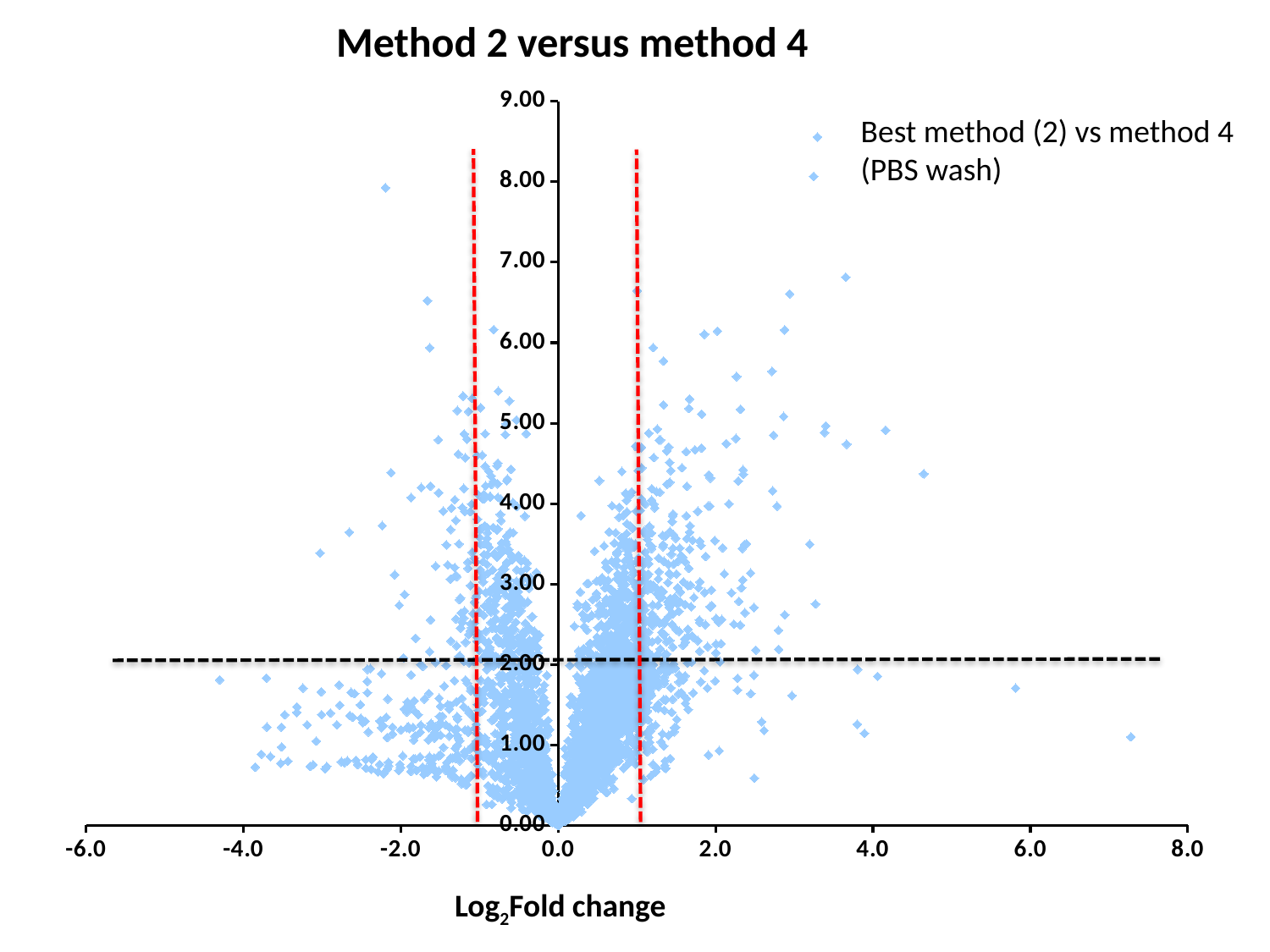
What is the maximum value shown on the y axis? 9.00 Is the y value of the highest plotted point greater or less than 7.00? greater What is the title of the chart? Method 2 versus method 4 What is the legend entry for the plotted series? Best method (2) vs method 4 (PBS wash) What is the label of the x axis? Log2Fold change How many series does the legend list? 1 What is the maximum value shown on the x axis? 8.0 What is the minimum value shown on the x axis? -6.0 What kind of chart is shown on the slide? Scatter plot Is the y value of the rightmost plotted point (near x = 7.3) greater or less than 2.00? less